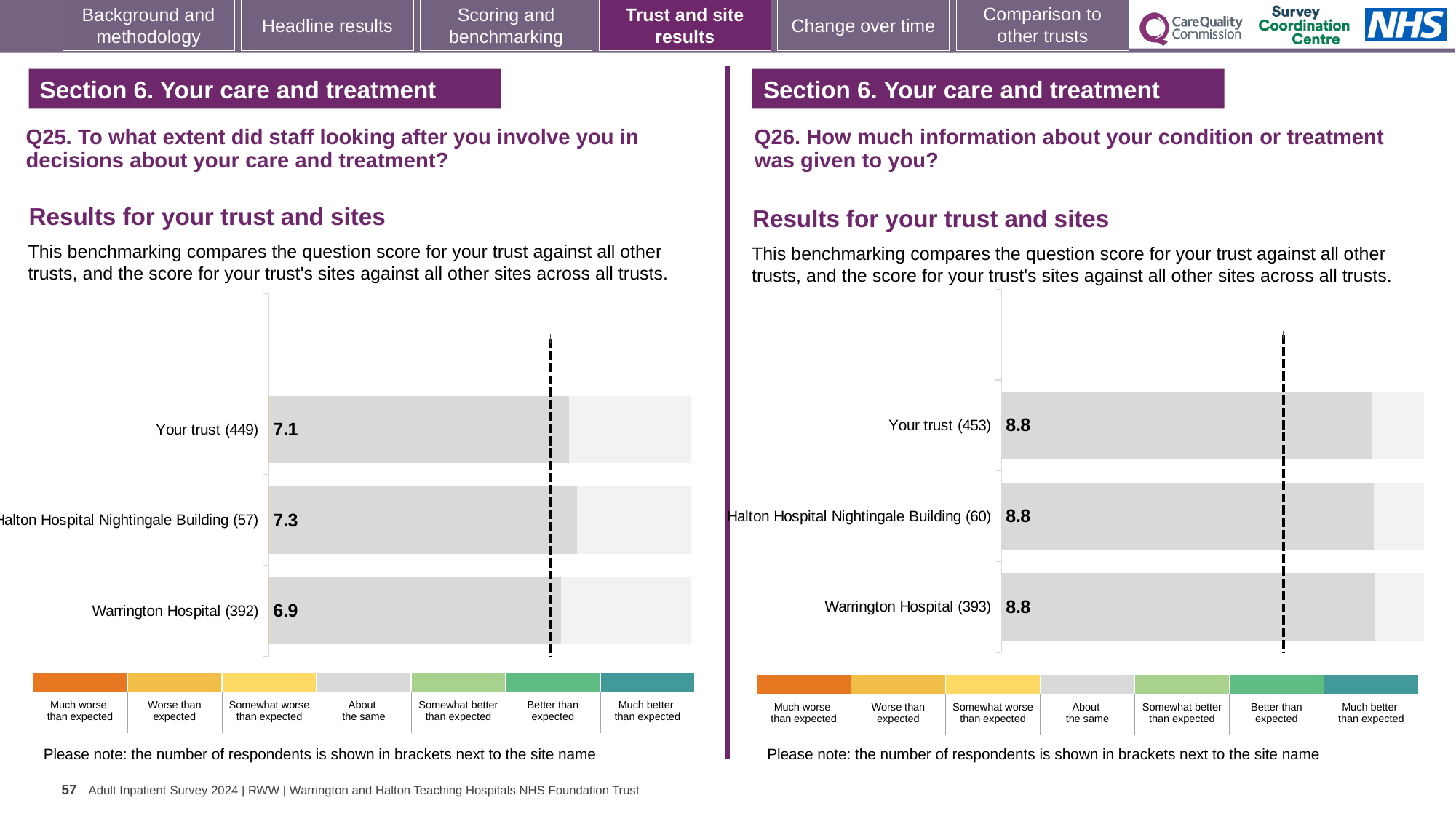
In the Q26 chart on the right, what is the score for Warrington Hospital (393)? 8.8 How many bars are plotted in the Q26 chart on the right? 3 In the Q26 chart on the right, what is the difference between the scores for Halton Hospital Nightingale Building (60) and Warrington Hospital (393)? 0 What type of chart is the Q25 chart on the left? Bar chart In the Q25 chart on the left, which site or trust has the highest score? Halton Hospital Nightingale Building (57) In the Q25 chart on the left, which has the larger score: Your trust (449) or Warrington Hospital (392)? Your trust (449) In the Q26 chart on the right, what is the score for Your trust (453)? 8.8 In the Q25 chart on the left, what is the difference between the scores for Halton Hospital Nightingale Building (57) and Warrington Hospital (392)? 0.4 In the Q25 chart on the left, what is the score for Warrington Hospital (392)? 6.9 In the Q25 chart on the left, what is the score for Halton Hospital Nightingale Building (57)? 7.3 In the Q25 chart on the left, what is the score for Your trust (449)? 7.1 In the Q25 chart on the left, which site or trust has the lowest score? Warrington Hospital (392)